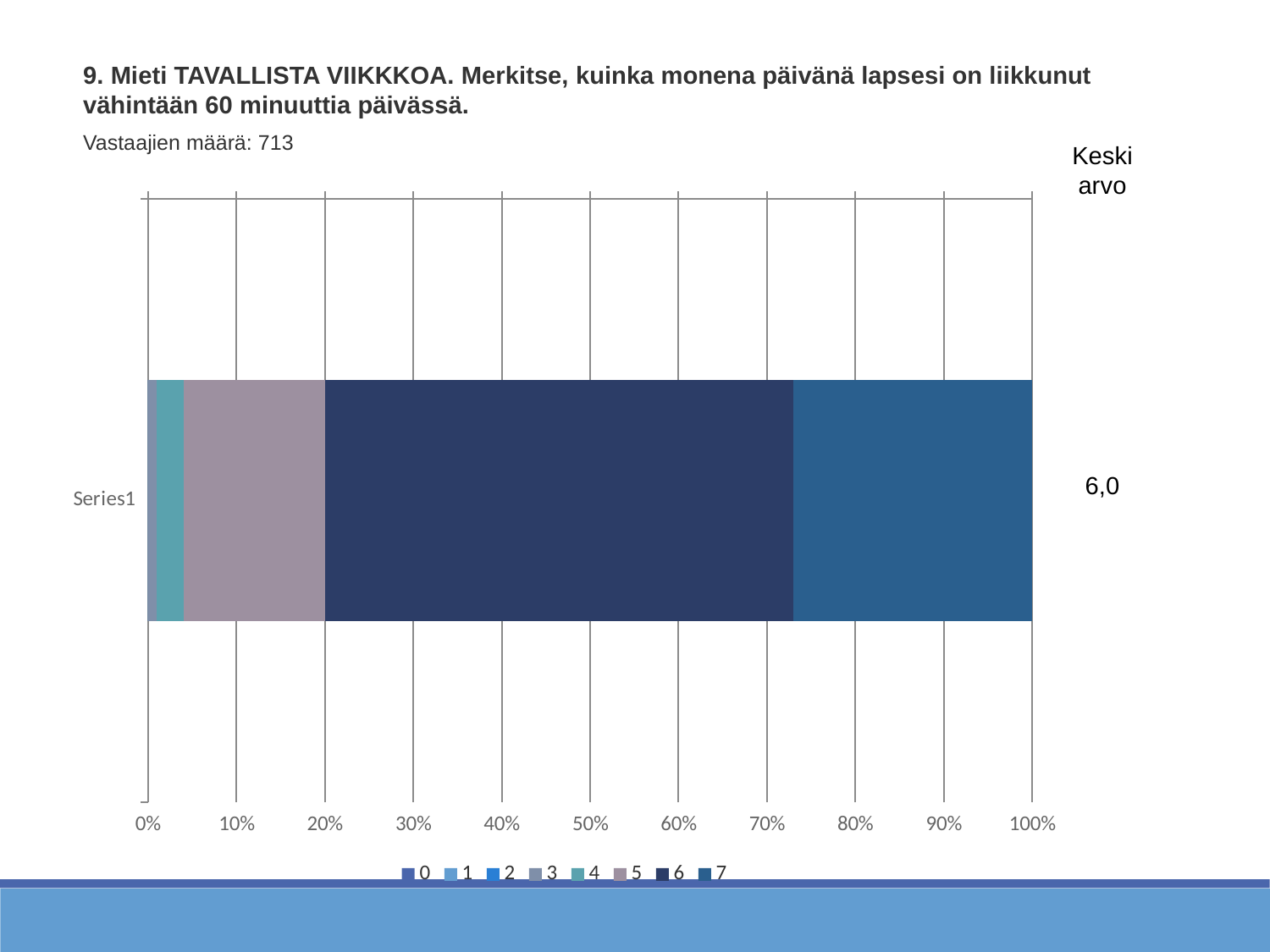
Is the segment for 5 in the Series1 bar greater or less than 10%? greater Is the segment for 7 in the Series1 bar greater or less than 30%? less How many categories are plotted on the vertical axis? 1 Which segment is larger in the Series1 bar, 4 or 5? 5 What is the Keskiarvo (mean value) shown to the right of the chart? 6,0 What kind of chart is shown on the slide? bar chart What is the number of respondents (Vastaajien määrä) shown above the chart? 713 Is the segment for 6 in the Series1 bar greater or less than 50%? greater Which legend entry has the largest segment in the Series1 bar? 6 How many series does the legend list? 8 Which segment is larger in the Series1 bar, 6 or 7? 6